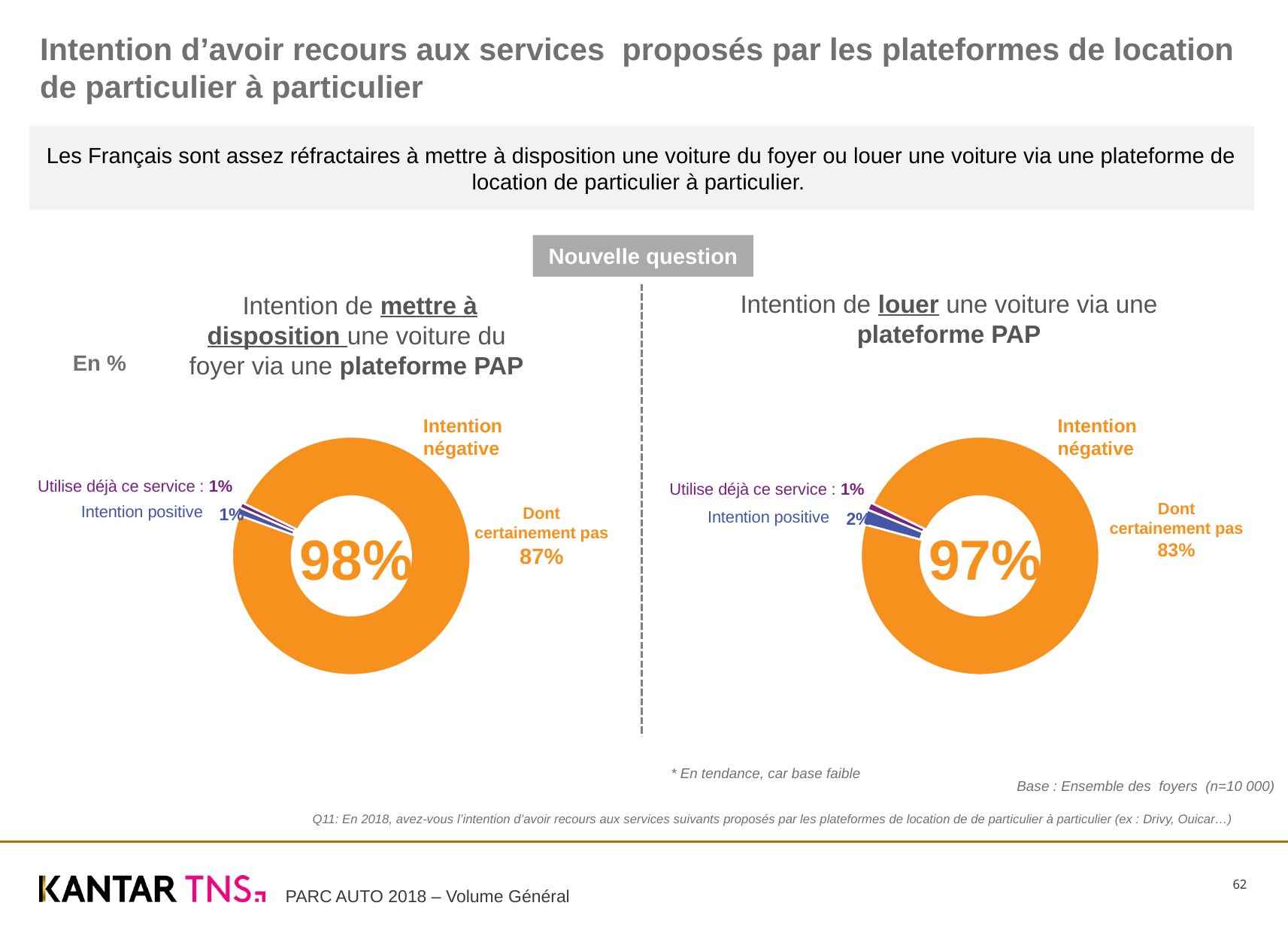
What is the difference between 'Dont certainement pas' in the left chart (87%) and in the right chart (83%)? 4% In the left chart (mettre à disposition), which category is the largest? Intention négative In the right chart (Intention de louer une voiture via une plateforme PAP), what is the value for Intention négative? 97% In the right chart (louer), what share answered 'Dont certainement pas'? 83% In the left chart (mettre à disposition), what is the value for 'Utilise déjà ce service'? 1% How many charts are shown on the slide? 2 What is the difference between the Intention négative values of the left chart (98%) and the right chart (97%)? 1% In the right chart (louer), what is the value for Intention positive? 2% Which chart has the larger Intention positive value, the left (mettre à disposition) or the right (louer)? the right (louer) In the left chart (mettre à disposition), what share answered 'Dont certainement pas'? 87% What type of chart is used on this slide? donut (pie) chart In the left chart (Intention de mettre à disposition une voiture du foyer via une plateforme PAP), what is the value for Intention négative? 98%